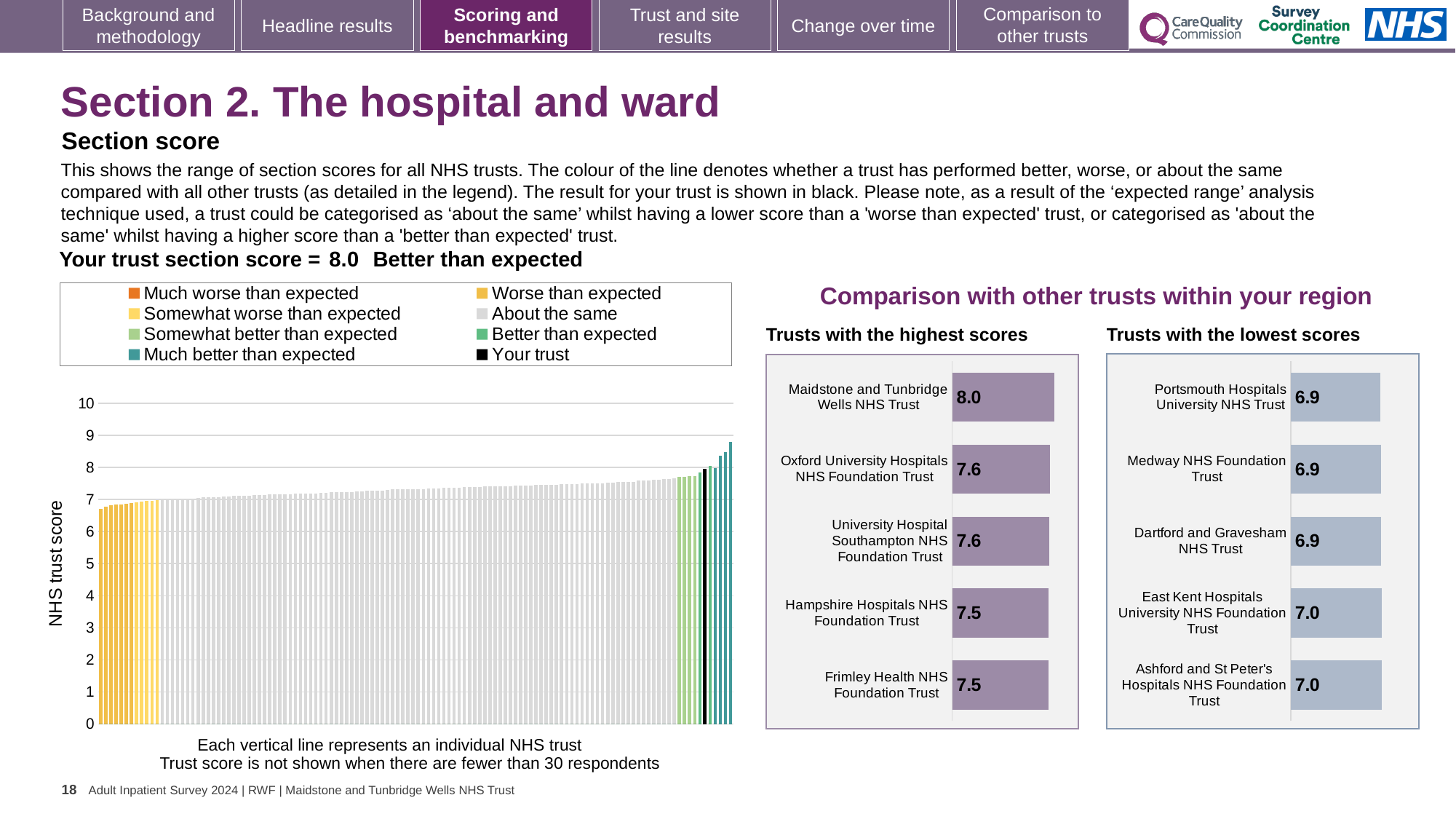
In the large chart on the left showing all NHS trusts, is the value for the black 'Your trust' bar greater or less than 7? greater In the 'Trusts with the highest scores' chart, which has the larger score: Oxford University Hospitals NHS Foundation Trust or Frimley Health NHS Foundation Trust? Oxford University Hospitals NHS Foundation Trust In the 'Trusts with the lowest scores' chart, what is the difference between the scores of Ashford and St Peter's Hospitals NHS Foundation Trust and Portsmouth Hospitals University NHS Trust? 0.1 How many entries does the legend above the large chart on the left list? 8 In the 'Trusts with the highest scores' chart, which trust has the highest score? Maidstone and Tunbridge Wells NHS Trust How many trusts are shown in the 'Trusts with the lowest scores' chart? 5 In the large chart on the left, do the trust scores rise or fall from left to right along the x axis? rise In the 'Trusts with the lowest scores' chart, what is the score for East Kent Hospitals University NHS Foundation Trust? 7.0 In the 'Trusts with the highest scores' chart, what is the score for Maidstone and Tunbridge Wells NHS Trust? 8.0 In the 'Trusts with the highest scores' chart, what is the difference between the scores of Maidstone and Tunbridge Wells NHS Trust and Frimley Health NHS Foundation Trust? 0.5 What kind of chart is the large chart on the left showing NHS trust scores? bar chart In the 'Trusts with the highest scores' chart, what is the score for Hampshire Hospitals NHS Foundation Trust? 7.5